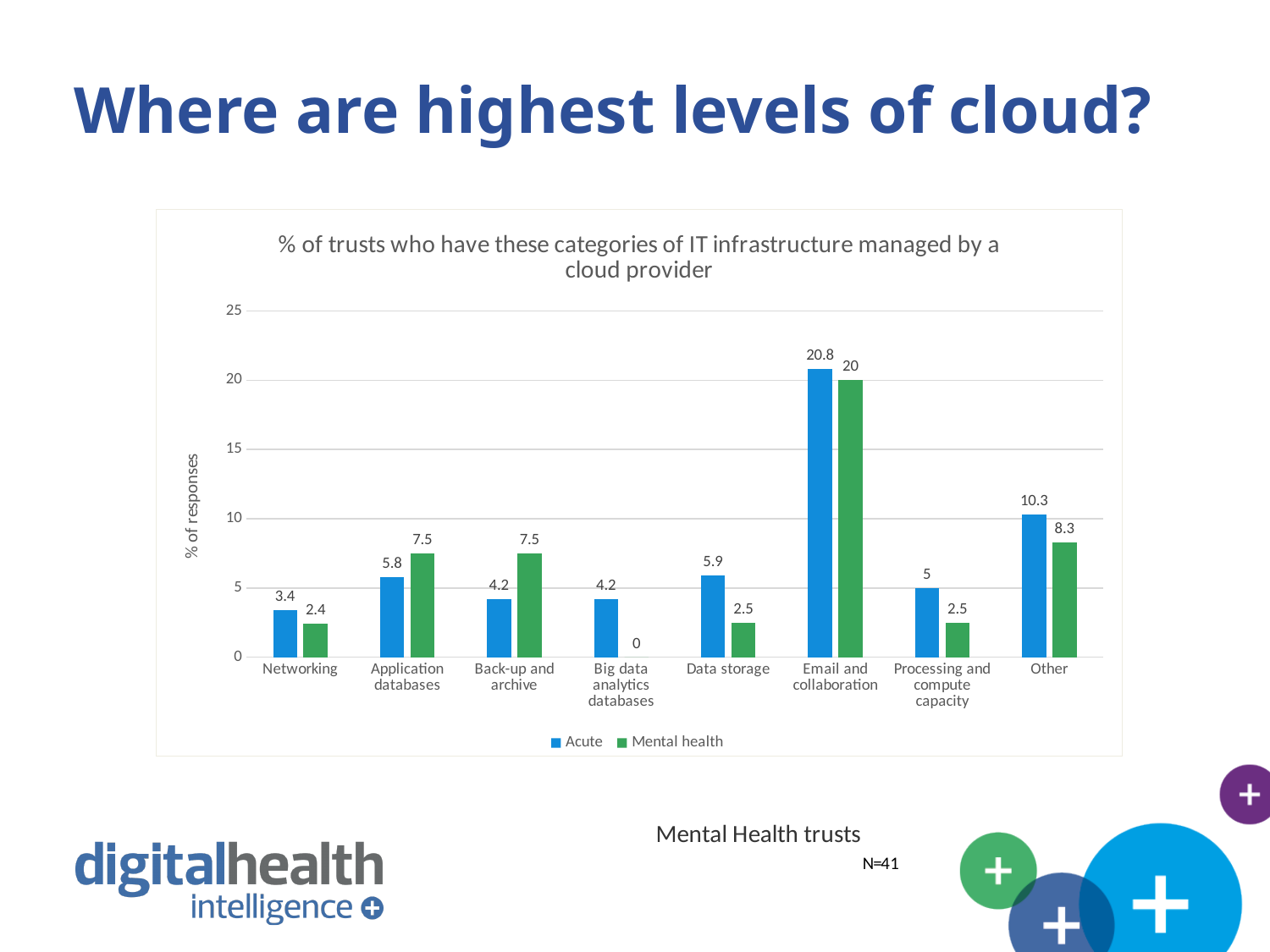
What is the Mental health value for Networking? 2.4 What is the label of the vertical axis? % of responses How many series does the legend list? 2 What kind of chart is shown on the slide? Bar chart How many categories are shown on the x axis? 8 Which is larger for Application databases, the Acute value or the Mental health value? Mental health Is the Acute value for Other greater or less than 10? greater Which category has the highest Acute value? Email and collaboration What is the Mental health value for Big data analytics databases? 0 What is the difference between the Acute and Mental health values for Other? 2 What is the Acute value for Email and collaboration? 20.8 Which category has the lowest Mental health value? Big data analytics databases